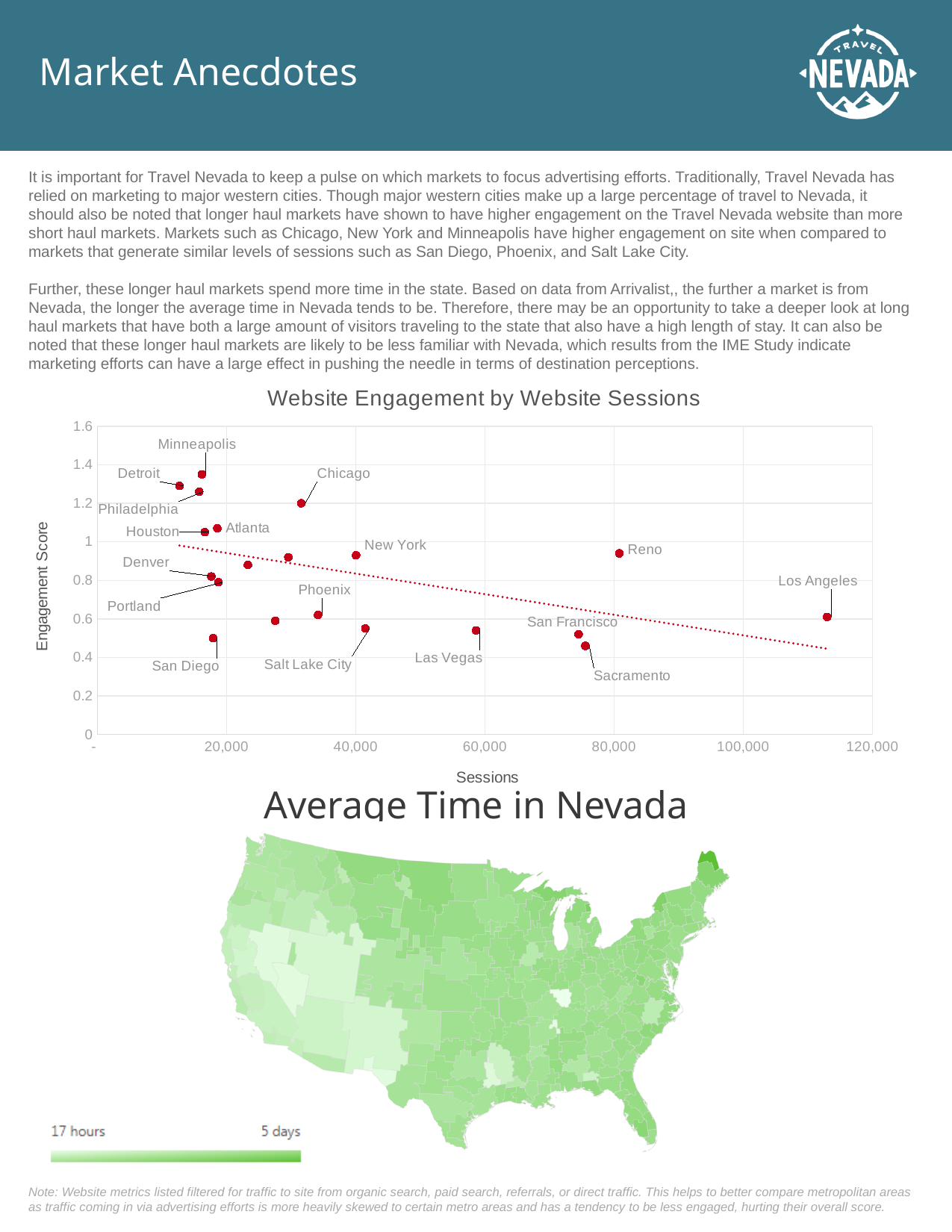
What is the title of the vertical axis in the 'Website Engagement by Website Sessions' chart? Engagement Score In the 'Website Engagement by Website Sessions' chart, is the number of sessions for Los Angeles greater or less than 100,000? greater In the 'Website Engagement by Website Sessions' chart, is the engagement score for Chicago greater or less than 1? greater In the 'Website Engagement by Website Sessions' chart, is the engagement score for San Diego greater or less than 0.6? less In the 'Website Engagement by Website Sessions' chart, which has a higher engagement score, Chicago or Phoenix? Chicago In the 'Website Engagement by Website Sessions' chart, which has more sessions, Los Angeles or Reno? Los Angeles What kind of chart is 'Website Engagement by Website Sessions'? Scatter chart In the 'Website Engagement by Website Sessions' chart, which has a higher engagement score, New York or Las Vegas? New York In the 'Website Engagement by Website Sessions' chart, does the dotted trend line rise or fall as sessions increase? Fall In the 'Website Engagement by Website Sessions' chart, which labeled market has the most sessions? Los Angeles